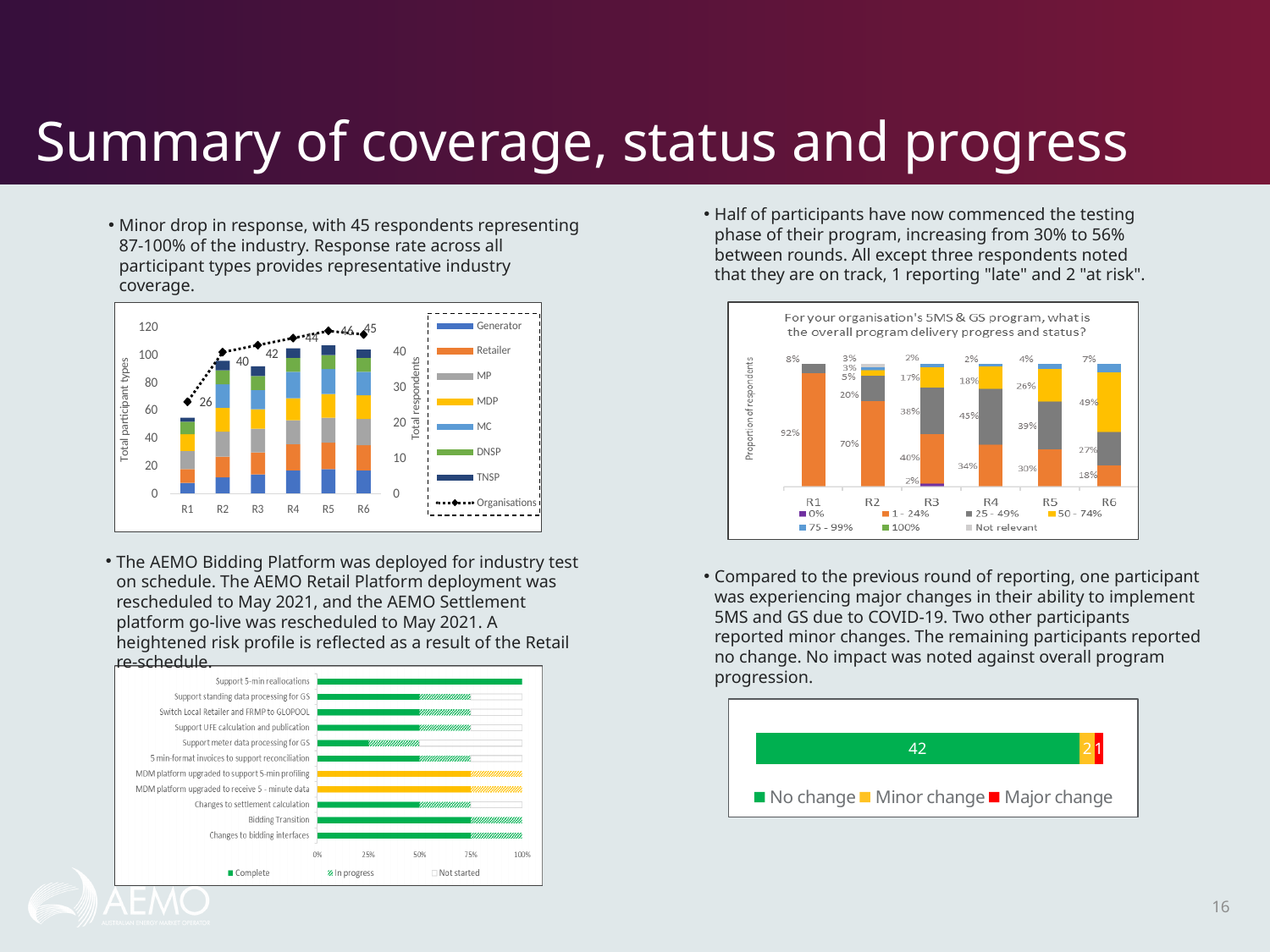
In the top-left chart, what is the difference between the Organisations values for R5 and R1? 20 In the bottom-right chart, what is the value for No change? 42 In the chart titled 'For your organisation's 5MS & GS program, what is the overall program delivery progress and status?', what is the value for the 1 - 24% series in R1? 92% In the bottom-right chart, how many series does the legend list? 3 In the bottom-right chart, what is the total of the stacked bar across No change, Minor change and Major change? 45 What kind of chart is the bottom-left chart? Bar chart In the bottom-right chart, what is the value for Minor change? 2 In the top-left chart, what is the Organisations value for R1? 26 In the chart titled 'For your organisation's 5MS & GS program, what is the overall program delivery progress and status?', what is the value for the 50 - 74% series in R6? 49% In the bottom-left chart, how many categories (activities) are listed on the vertical axis? 11 In the top-left chart, which round has the lowest Organisations value? R1 In the top-left chart, what is the Organisations value for R6? 45